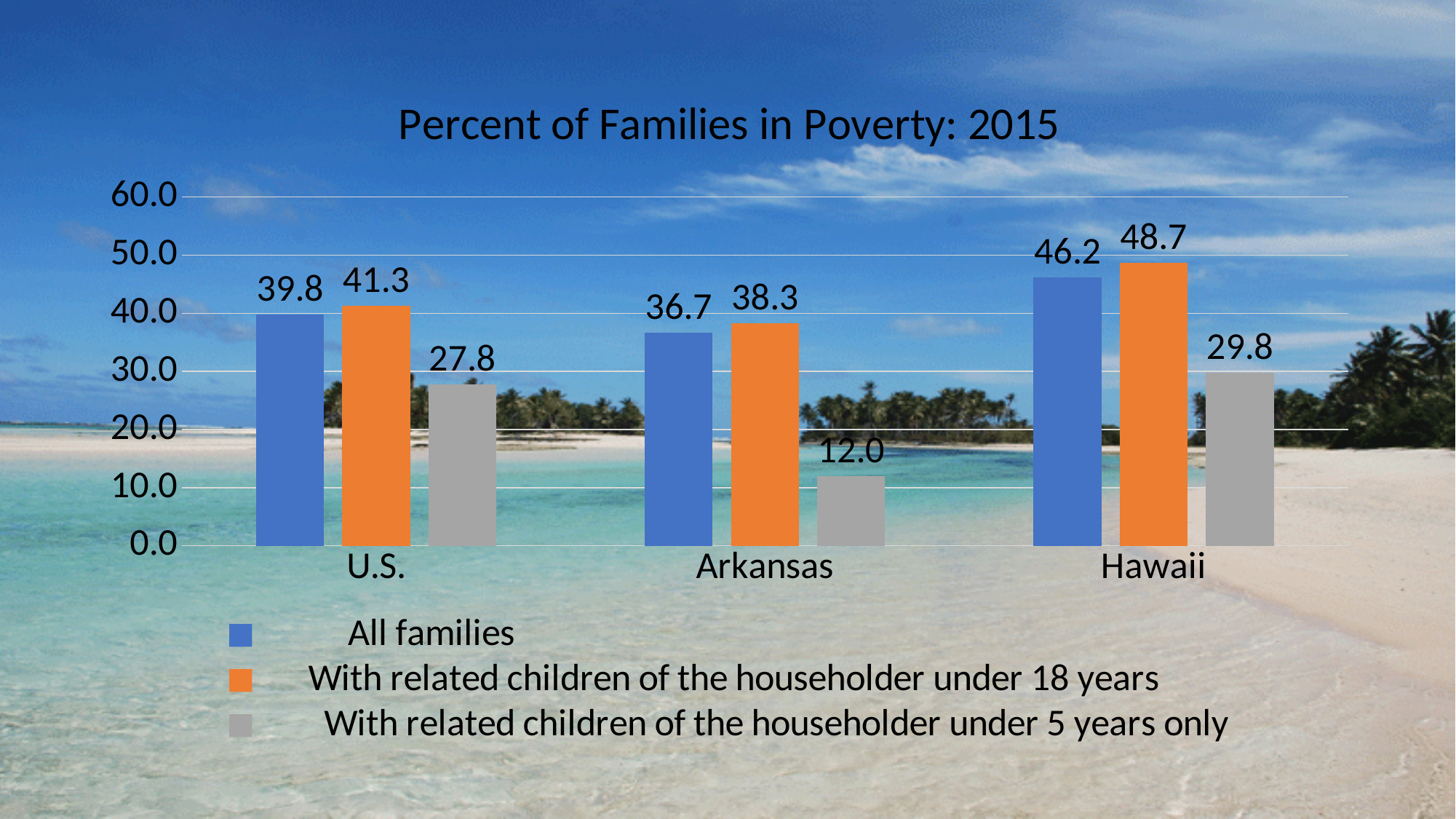
Which category has the highest value for With related children of the householder under 18 years? Hawaii How many series does the legend list? 3 Which category has the lowest value for All families? Arkansas Is the value for With related children of the householder under 5 years only in Arkansas greater or less than 20.0? less What is the title of the chart? Percent of Families in Poverty: 2015 What is the value for With related children of the householder under 5 years only in Arkansas? 12.0 How many categories are shown on the x axis? 3 What is the difference between the All families values for Hawaii and Arkansas? 9.5 Which is larger: the value for With related children of the householder under 5 years only in the U.S. or in Hawaii? Hawaii What is the value for All families in Hawaii? 46.2 What kind of chart is shown on the slide? bar chart What is the value for With related children of the householder under 18 years in the U.S.? 41.3